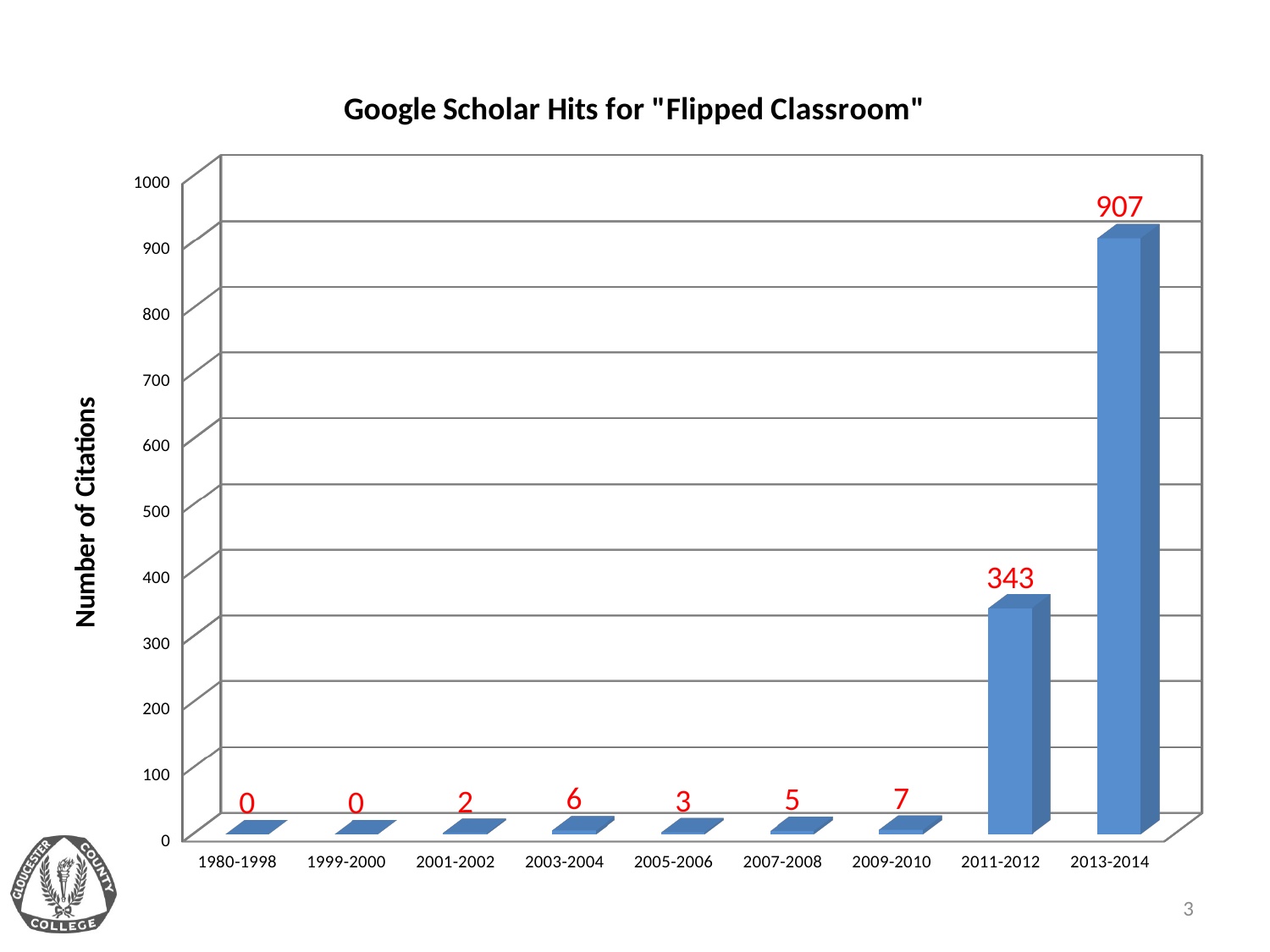
What is the number of citations for 2013-2014? 907 What is the difference in citations between 2013-2014 and 2011-2012? 564 What kind of chart is shown on the slide? bar chart Which period has the highest number of citations? 2013-2014 Do the values generally rise or fall from left to right along the x axis? rise Is the value for 2011-2012 greater or less than 400? less How many time periods are shown on the x axis? 9 What is the number of citations for 2009-2010? 7 What is the title of the chart? Google Scholar Hits for "Flipped Classroom" Which has more citations, 2005-2006 or 2007-2008? 2007-2008 What is the number of citations for 2003-2004? 6 What is the number of citations for 2011-2012? 343